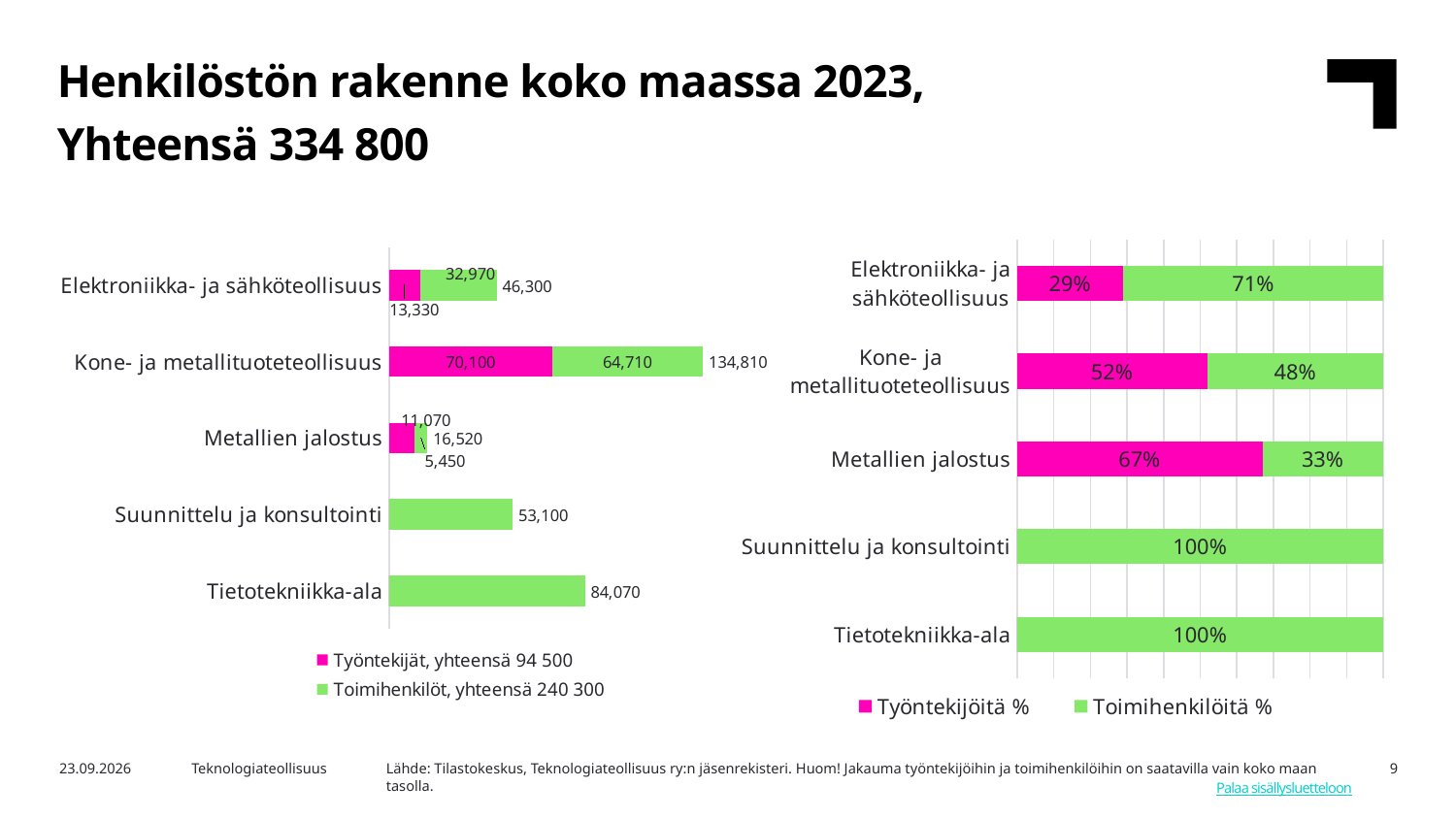
In the left chart, what is the total value shown for Kone- ja metallituoteteollisuus? 134,810 In the right chart, what is the Toimihenkilöitä % for Kone- ja metallituoteteollisuus? 48% In the left chart, what is the value shown for Tietotekniikka-ala? 84,070 In the left chart, which category has the lowest total? Metallien jalostus In the left chart, what is the Toimihenkilöt value for Elektroniikka- ja sähköteollisuus? 32,970 How many series does the legend of the right chart list? 2 How many categories are shown in the left chart? 5 In the right chart, what is the Työntekijöitä % for Metallien jalostus? 67% In the left chart, which is larger: the total for Suunnittelu ja konsultointi or the total for Elektroniikka- ja sähköteollisuus? Suunnittelu ja konsultointi What type of chart is the right chart? Stacked bar chart In the left chart, which category has the highest total? Kone- ja metallituoteteollisuus In the left chart, what is the difference between the Työntekijät and Toimihenkilöt values for Kone- ja metallituoteteollisuus? 5,390